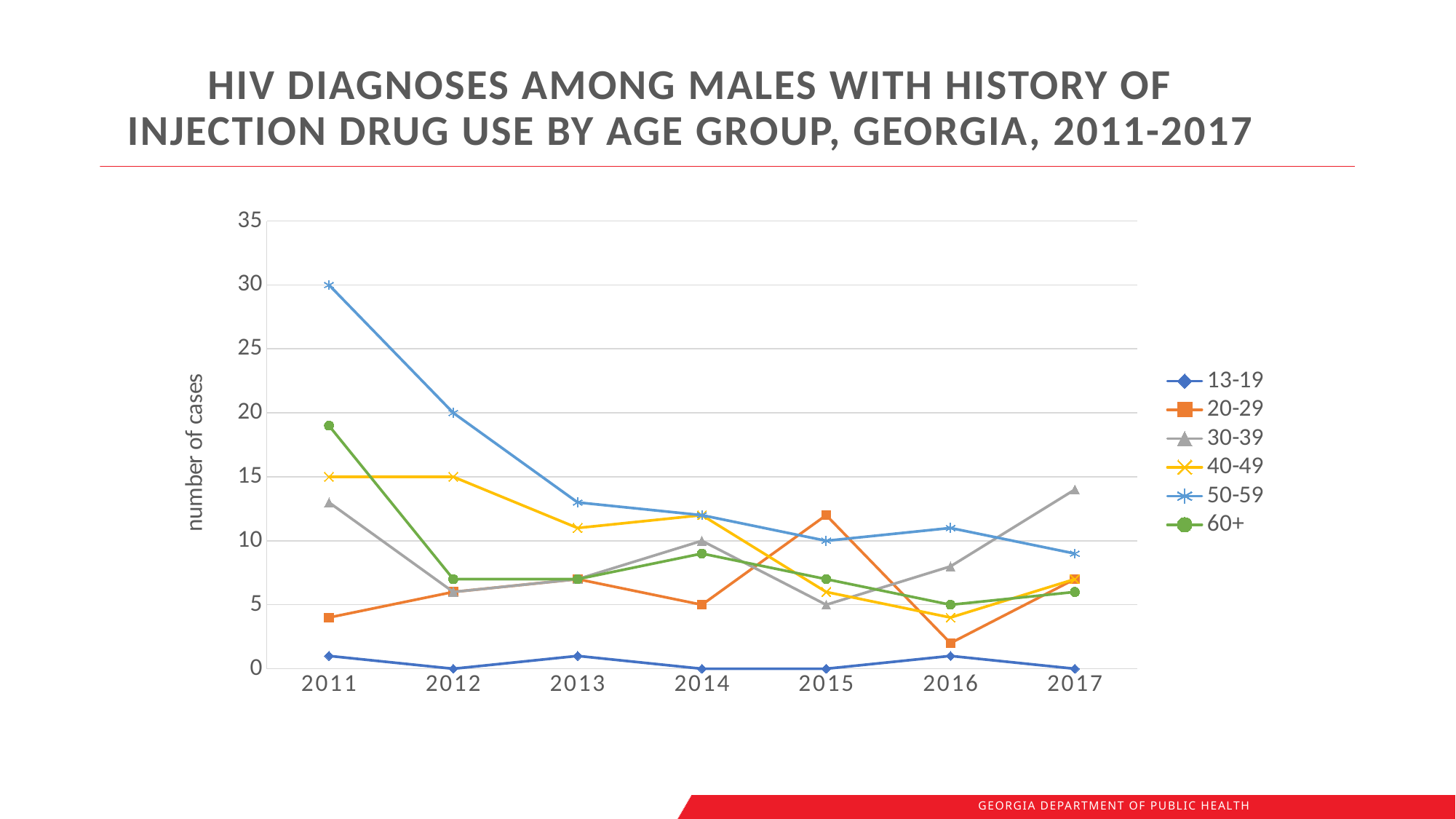
How many series does the legend list? 6 What is the number of cases for the 40-49 age group in 2011? 15 Which age group has the highest number of cases in 2011? 50-59 What is the number of cases for the 13-19 age group in 2017? 0 How many years are shown on the x axis? 7 What type of chart is shown on the slide? line chart Is the value for the 60+ age group in 2011 greater or less than 15? greater Does the 50-59 line rise or fall from 2011 to 2013? fall Which is larger in 2017, the value for 30-39 or the value for 50-59? 30-39 What is the number of cases for the 50-59 age group in 2011? 30 What is the number of cases for the 50-59 age group in 2012? 20 Which age group has the lowest number of cases in 2015? 13-19